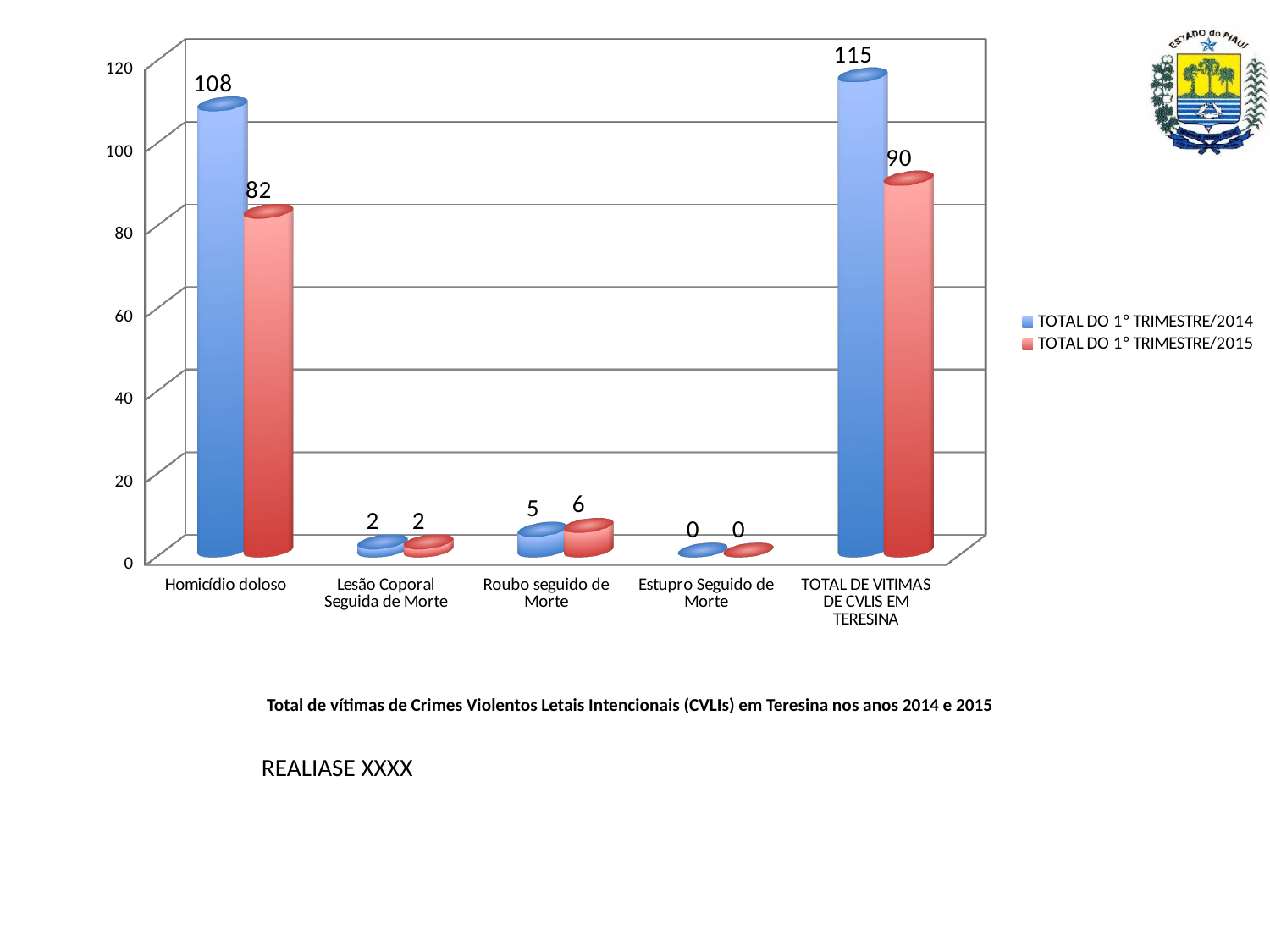
Which category has the highest value in the TOTAL DO 1° TRIMESTRE/2014 series? TOTAL DE VITIMAS DE CVLIS EM TERESINA For Roubo seguido de Morte, which series has the larger value, TOTAL DO 1° TRIMESTRE/2014 or TOTAL DO 1° TRIMESTRE/2015? TOTAL DO 1° TRIMESTRE/2015 What is the difference between the 2014 and 2015 values for Homicídio doloso? 26 What is the difference between the 2014 and 2015 values for TOTAL DE VITIMAS DE CVLIS EM TERESINA? 25 What kind of chart is shown on the slide? Bar chart How many categories are shown on the x axis? 5 Which category has the lowest value in the TOTAL DO 1° TRIMESTRE/2015 series? Estupro Seguido de Morte How many series does the legend list? 2 What is the value for Roubo seguido de Morte in the TOTAL DO 1° TRIMESTRE/2015 series? 6 What is the value for Homicídio doloso in the TOTAL DO 1° TRIMESTRE/2015 series? 82 What is the value for TOTAL DE VITIMAS DE CVLIS EM TERESINA in the TOTAL DO 1° TRIMESTRE/2014 series? 115 What is the value for Homicídio doloso in the TOTAL DO 1° TRIMESTRE/2014 series? 108